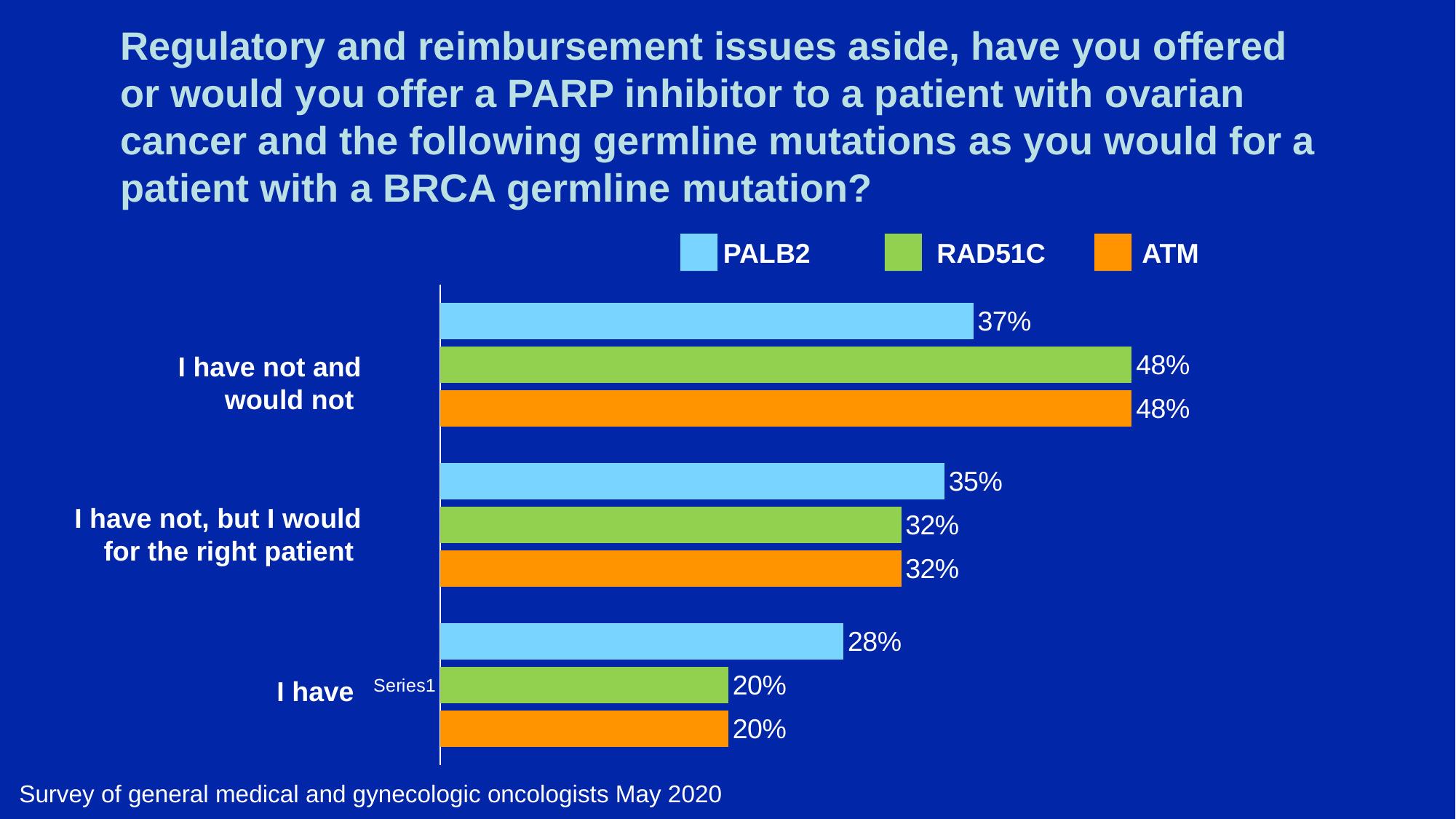
Which response category has the lowest ATM value? I have What is the difference between the PALB2 and ATM values for 'I have'? 8% What percentage of respondents said they have offered a PARP inhibitor for a patient with a PALB2 mutation? 28% What kind of chart is shown on the slide? Bar chart What is the ATM value for 'I have not, but I would for the right patient'? 32% Which response category has the highest PALB2 value? I have not and would not What is the RAD51C value for 'I have not and would not'? 48% Which series is shown in orange in the legend? ATM How many series does the legend list? 3 What is the PALB2 value for 'I have not, but I would for the right patient'? 35% For 'I have not, but I would for the right patient', which is larger: the PALB2 value or the RAD51C value? PALB2 What is the difference between the RAD51C and PALB2 values for 'I have not and would not'? 11%